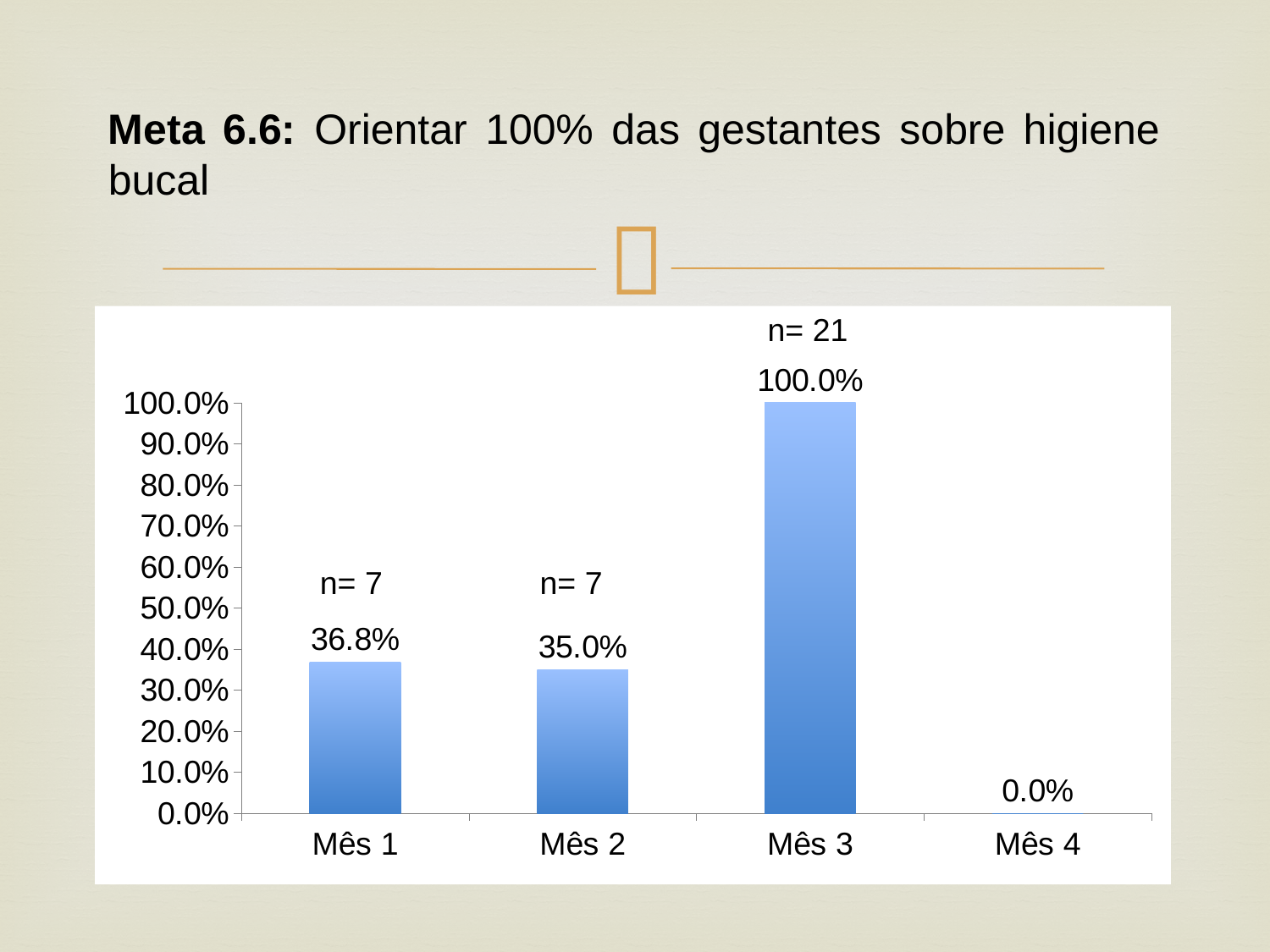
How many months are shown on the x axis? 4 What is the value for Mês 1? 36.8% What kind of chart is shown on the slide? Bar chart What is the value for Mês 3? 100.0% Which month has the lowest value? Mês 4 What is the value for Mês 4? 0.0% What is the difference between the values for Mês 1 and Mês 2? 1.8% What is the n value labelled above the bar for Mês 3? n= 21 What is the value for Mês 2? 35.0% Which is larger, the value for Mês 1 or Mês 2? Mês 1 Which month has the highest value? Mês 3 What is the difference between the values for Mês 3 and Mês 1? 63.2%